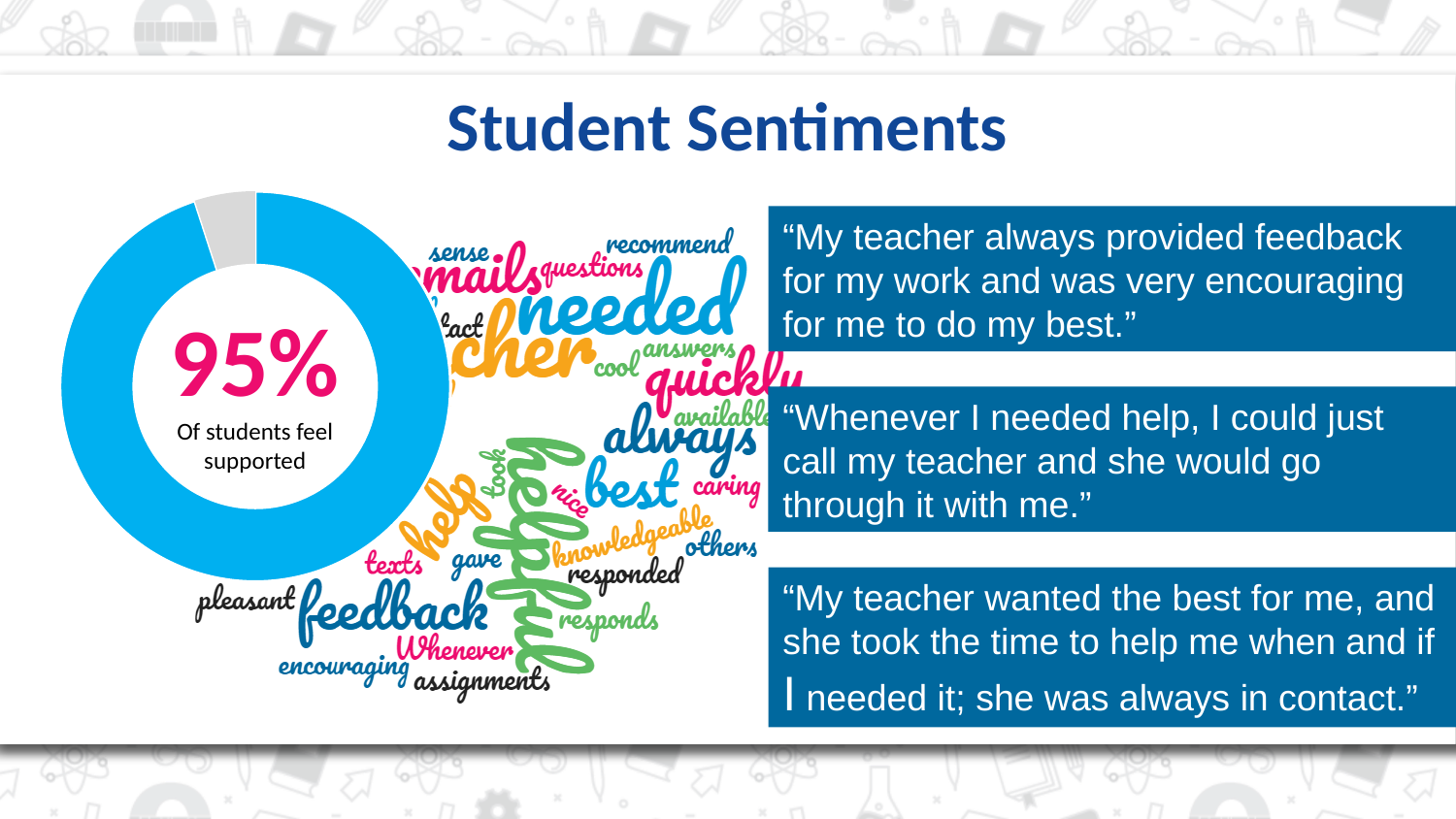
How many segments does the donut chart have? 2 What does the 95% in the centre of the donut chart represent? Of students feel supported What percentage of students feel supported, according to the chart? 95% What colour is the segment representing students who feel supported? blue What kind of chart is shown on the left of the slide? pie chart (donut) What share of the donut chart does the grey segment represent? 5% Which segment of the donut chart is larger, the blue one or the grey one? the blue one Is the value shown in the donut chart greater or less than 50%? greater